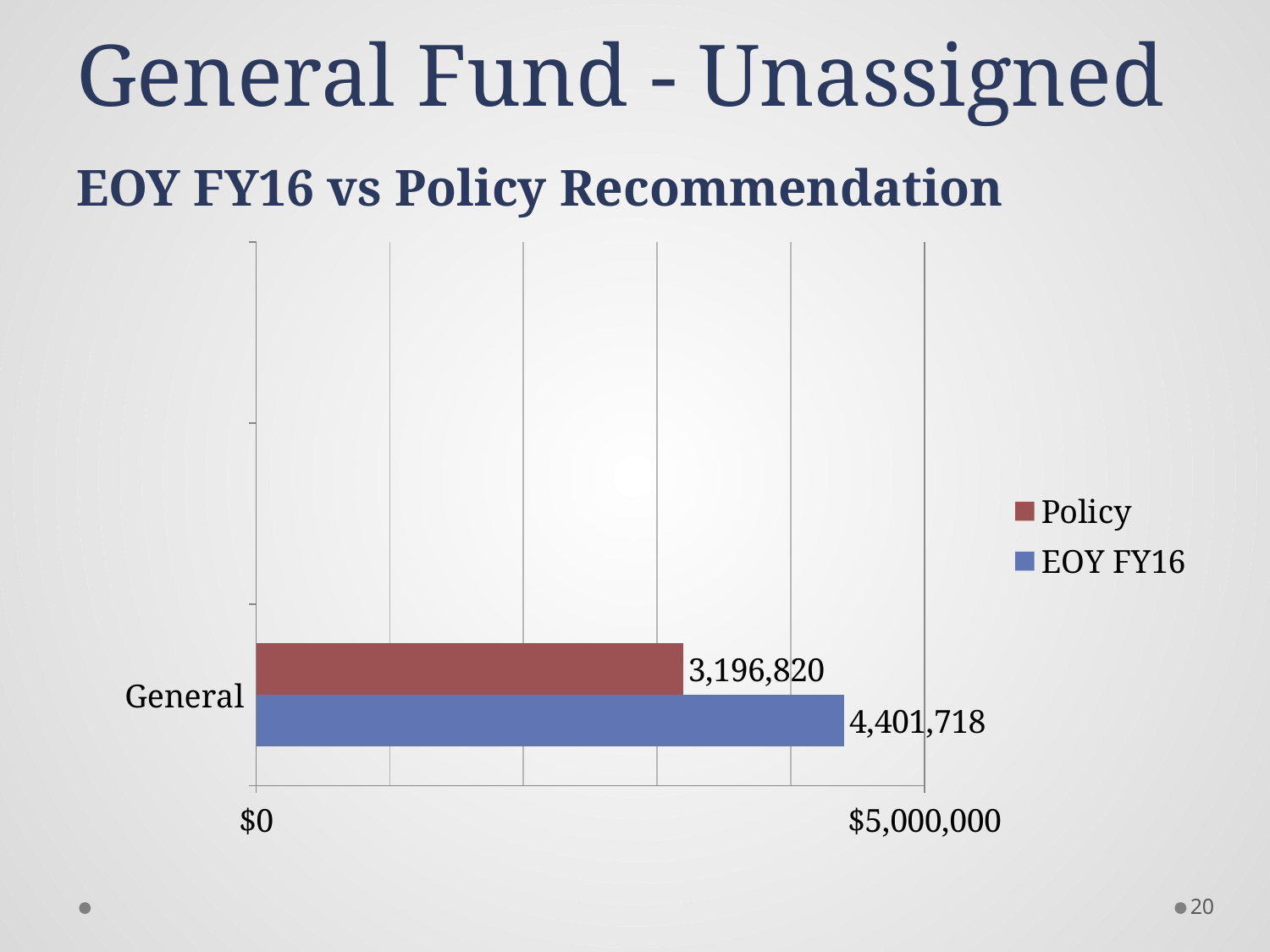
What is the difference between the EOY FY16 value and the Policy value for General? 1,204,898 What is the maximum value shown on the horizontal axis? $5,000,000 Which series is shown in red on the chart? Policy How many categories are shown on the chart? 1 Which series has the larger value for General, Policy or EOY FY16? EOY FY16 What kind of chart is shown on the slide? Bar chart What is the value of the EOY FY16 bar for General? 4,401,718 What is the value of the Policy bar for General? 3,196,820 How many series does the legend list? 2 What is the label of the category on the vertical axis? General Is the EOY FY16 value for General greater or less than $5,000,000? less